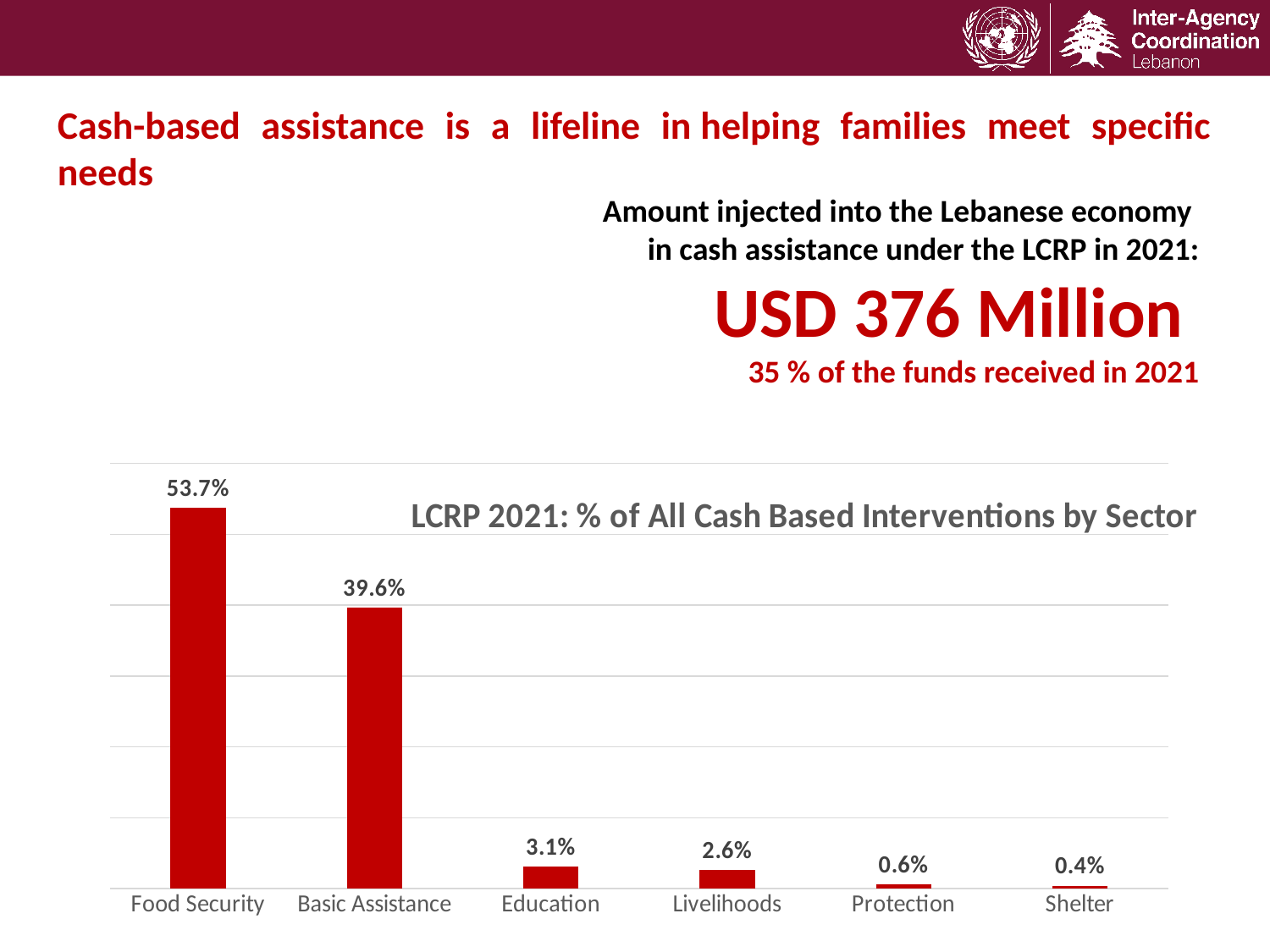
What is the value for Shelter? 0.4% What is the title of the chart? LCRP 2021: % of All Cash Based Interventions by Sector What is the value for Livelihoods? 2.6% What is the difference between the values for Food Security and Basic Assistance? 14.1% What kind of chart is shown on the slide? Bar chart How many sectors are shown in the chart? 6 What is the value for Basic Assistance? 39.6% Which sector has the highest share of cash based interventions? Food Security What is the value for Food Security? 53.7% Which is larger, the value for Education or the value for Livelihoods? Education What is the value for Education? 3.1% Which sector has the lowest share of cash based interventions? Shelter